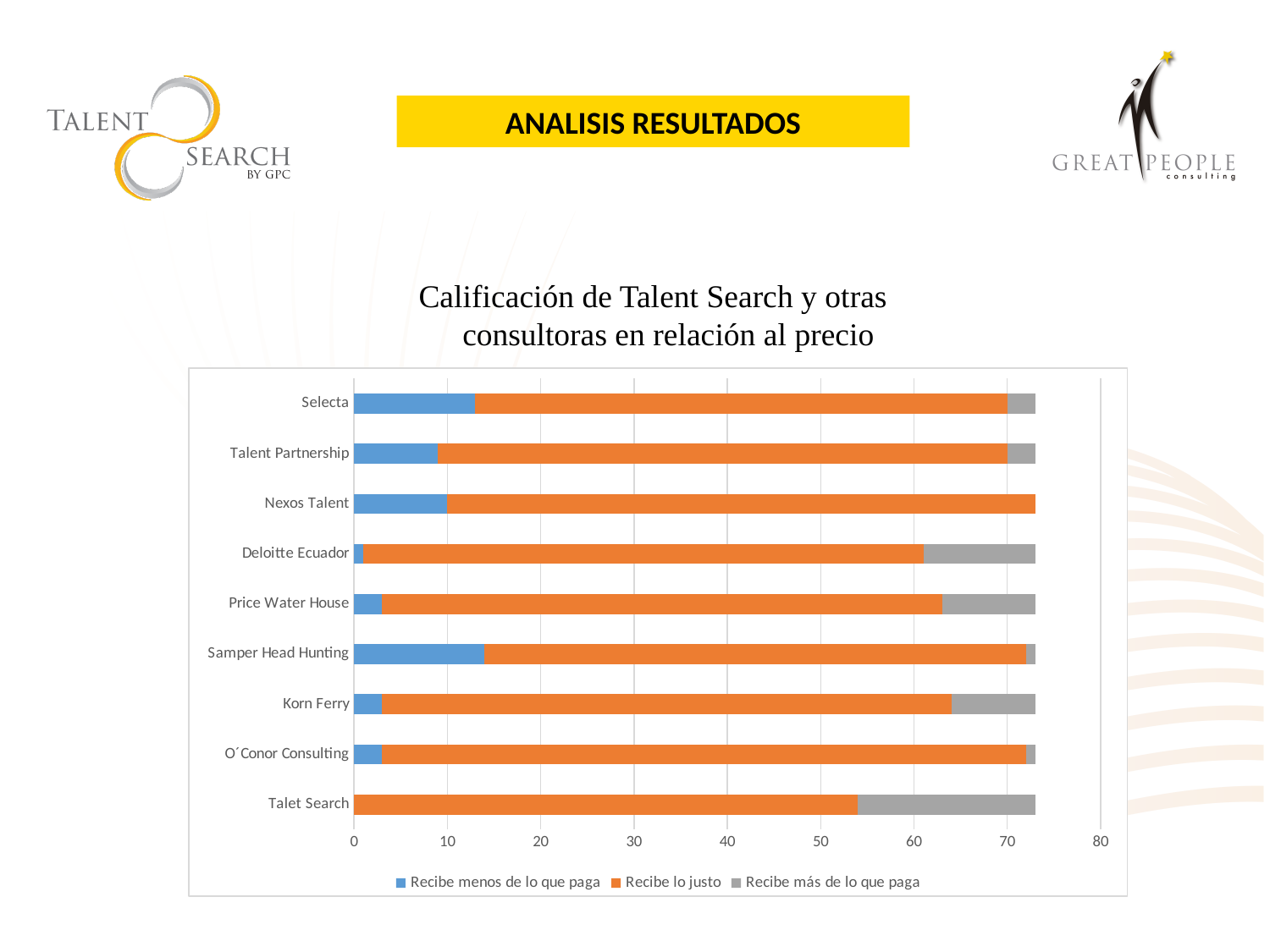
Is the 'Recibe lo justo' value for Talet Search greater or less than 50? greater Is the 'Recibe lo justo' value for Nexos Talent greater or less than 70? less What is the title of the chart? Calificación de Talent Search y otras consultoras en relación al precio Is the 'Recibe menos de lo que paga' value for Selecta greater or less than 10? greater Which legend entry is shown in orange? Recibe lo justo Which is larger: the 'Recibe más de lo que paga' segment for Deloitte Ecuador or for Selecta? Deloitte Ecuador Which is larger: the 'Recibe menos de lo que paga' segment for Samper Head Hunting or for Korn Ferry? Samper Head Hunting What kind of chart is shown on the slide? Stacked bar chart How many series does the legend list? 3 Which firm has the largest 'Recibe más de lo que paga' segment? Talet Search How many consulting firms (categories) are listed on the chart? 9